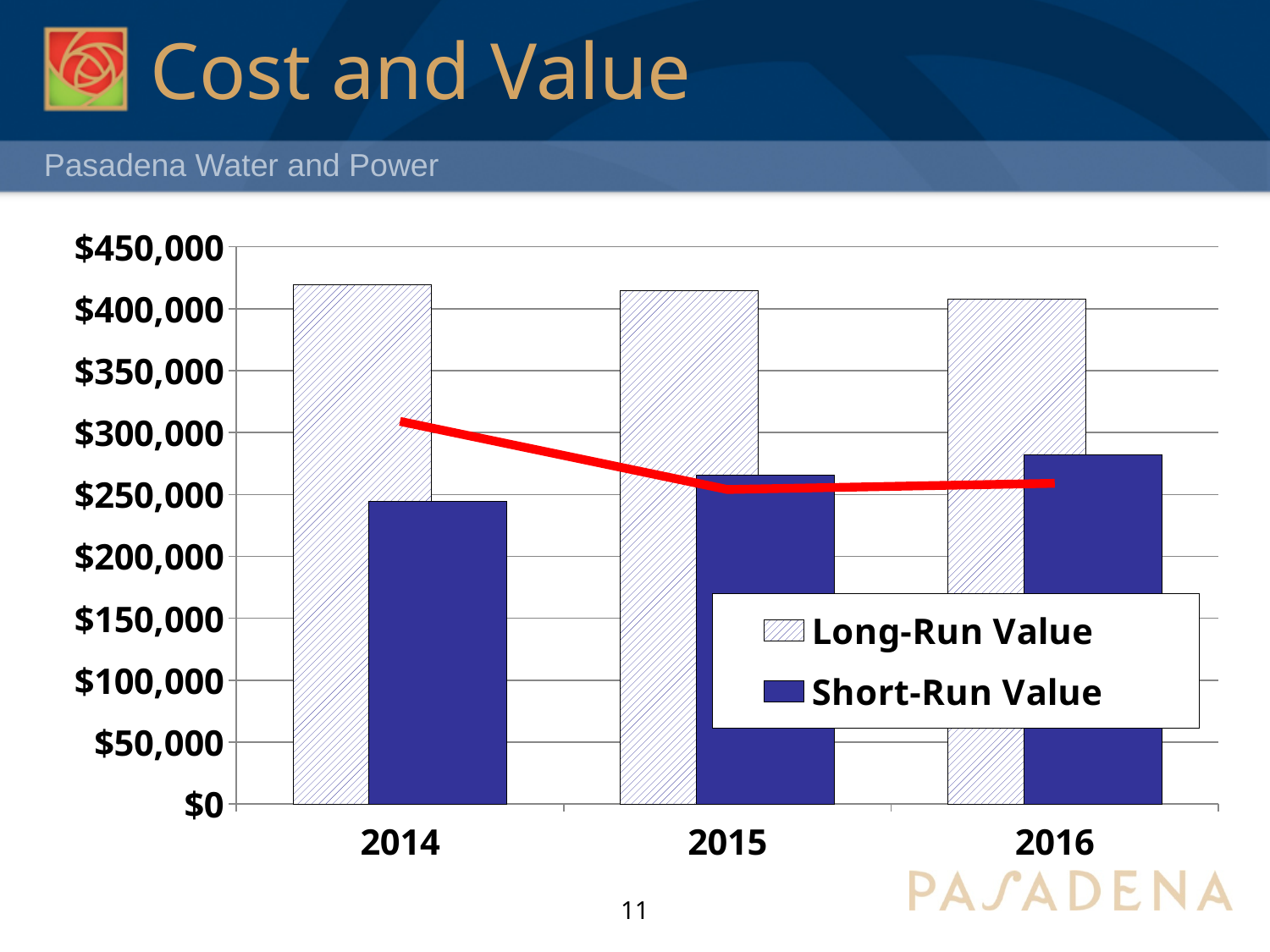
Is the Long-Run Value for 2014 greater or less than $400,000? greater Is the Short-Run Value for 2016 greater or less than $250,000? greater What kind of chart is shown on the slide? combination bar and line chart How many series does the chart's legend list? 2 Which year has the lowest Short-Run Value? 2014 How many years are shown on the x axis of the chart? 3 Which year has the highest Short-Run Value? 2016 In 2015, which is larger, the Long-Run Value or the Short-Run Value? Long-Run Value What are the two series named in the chart's legend? Long-Run Value and Short-Run Value Is the Long-Run Value for 2016 greater or less than $350,000? greater Does the Short-Run Value rise or fall from 2014 to 2016? rise